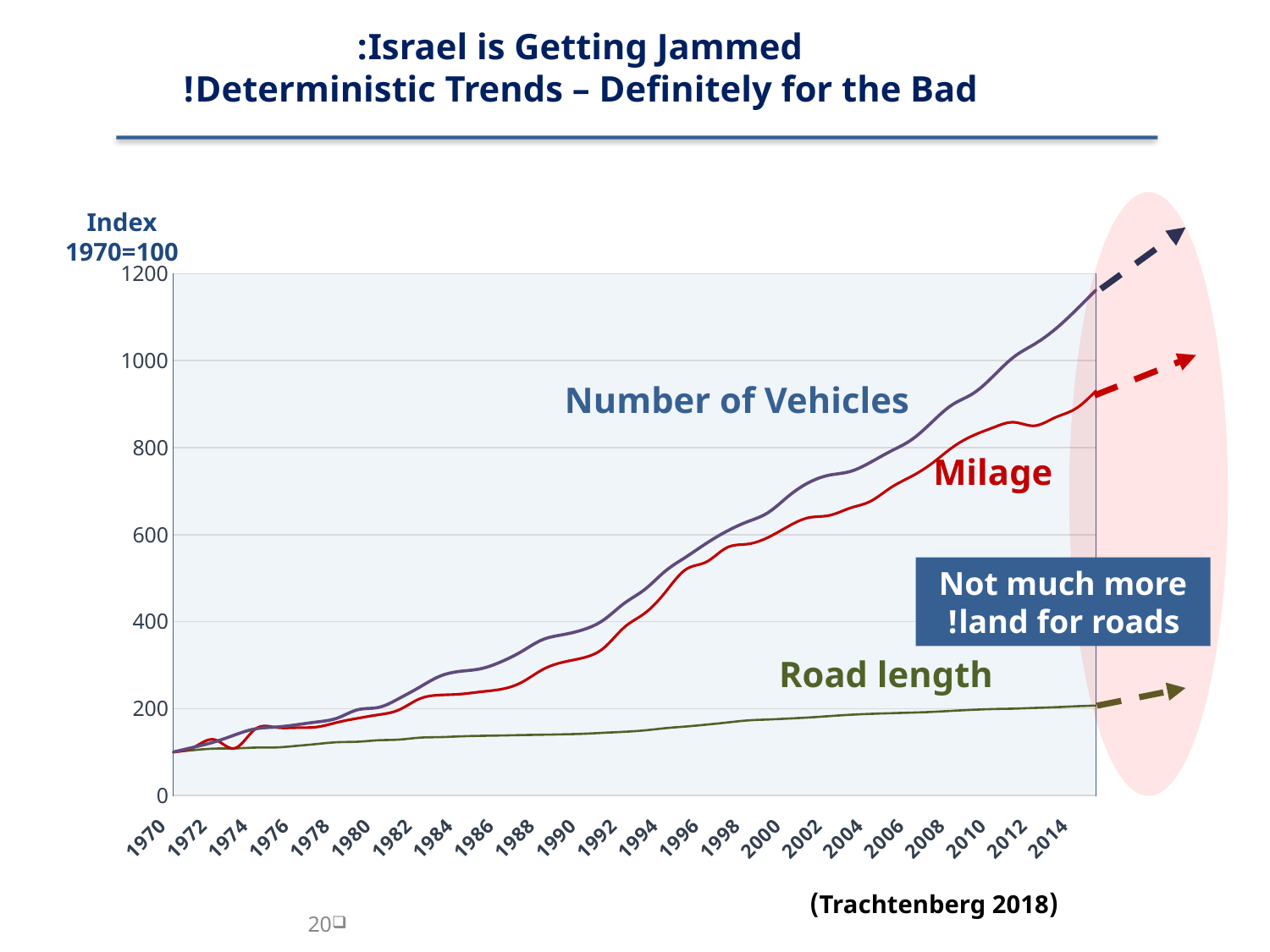
Is the value for Road length in 2014 greater or less than 400? less Which is larger in 2000, Milage or Road length? Milage What is the index value of all three series in 1970? 100 Which series has the highest value in 2014? Number of Vehicles Is the value for Milage in 2014 greater or less than 800? greater What is the source cited below the chart? (Trachtenberg 2018) Which series has the lowest value in 2014? Road length What kind of chart is shown on the slide? line chart How many data series are plotted on the chart? 3 How many year labels are shown on the x axis? 23 Is the value for Number of Vehicles in 2014 greater or less than 1000? greater Do the values for Number of Vehicles rise or fall from 1970 to 2014? rise